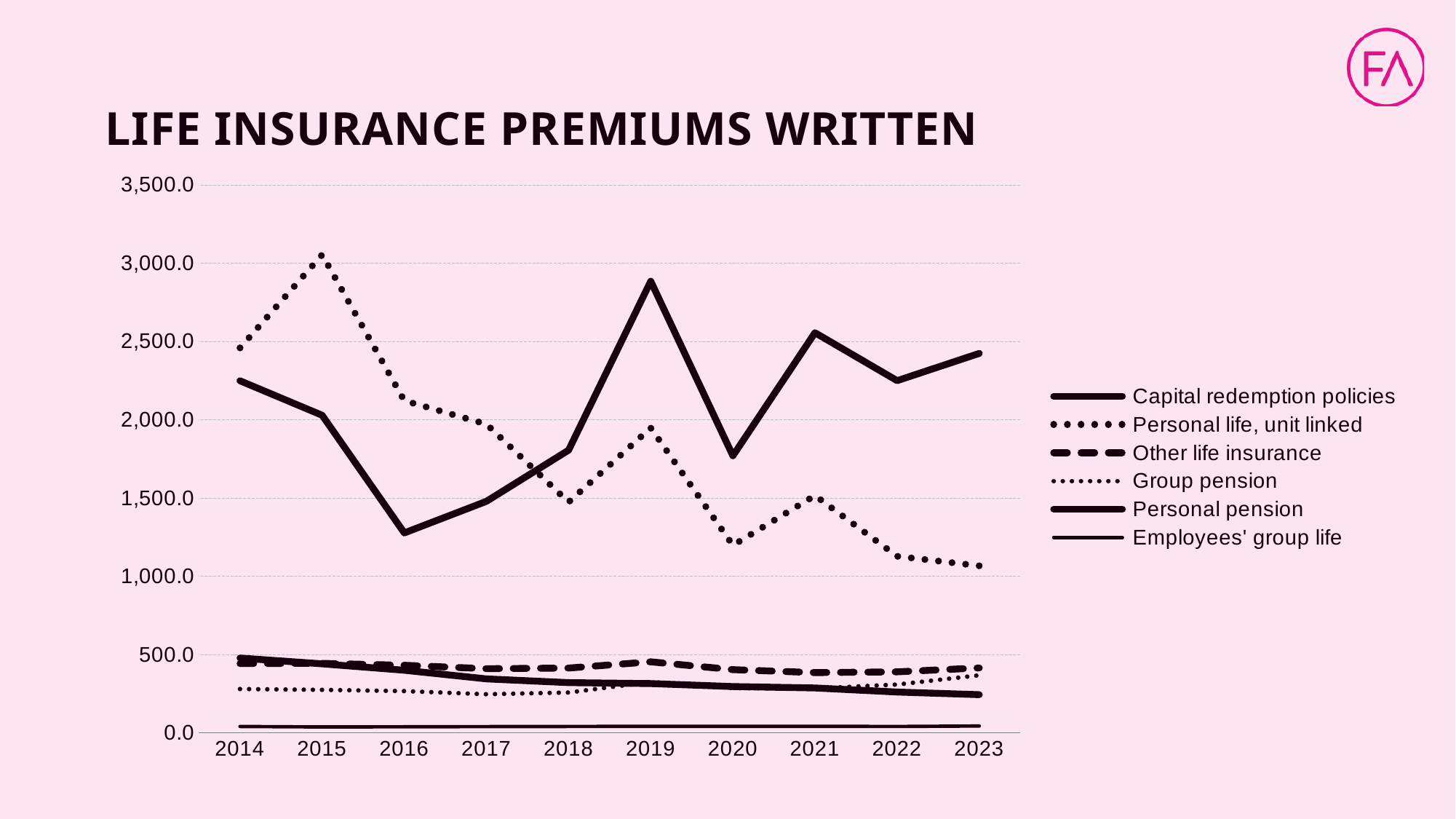
Is the value for Personal life, unit linked in 2023 greater or less than 1,500? less What kind of chart is shown on the slide? line chart Is the value for Capital redemption policies in 2016 greater or less than 1,500? less In 2014, which is higher: Capital redemption policies or Personal life, unit linked? Personal life, unit linked Which series has the lowest values across the whole chart? Employees' group life How many series does the legend list? 6 Is the value for Personal life, unit linked in 2015 greater or less than 2,500? greater How many years are shown on the x axis? 10 In which year does the Capital redemption policies line reach its highest value? 2019 What is the title of the chart? LIFE INSURANCE PREMIUMS WRITTEN In which year does the Personal life, unit linked line reach its highest value? 2015